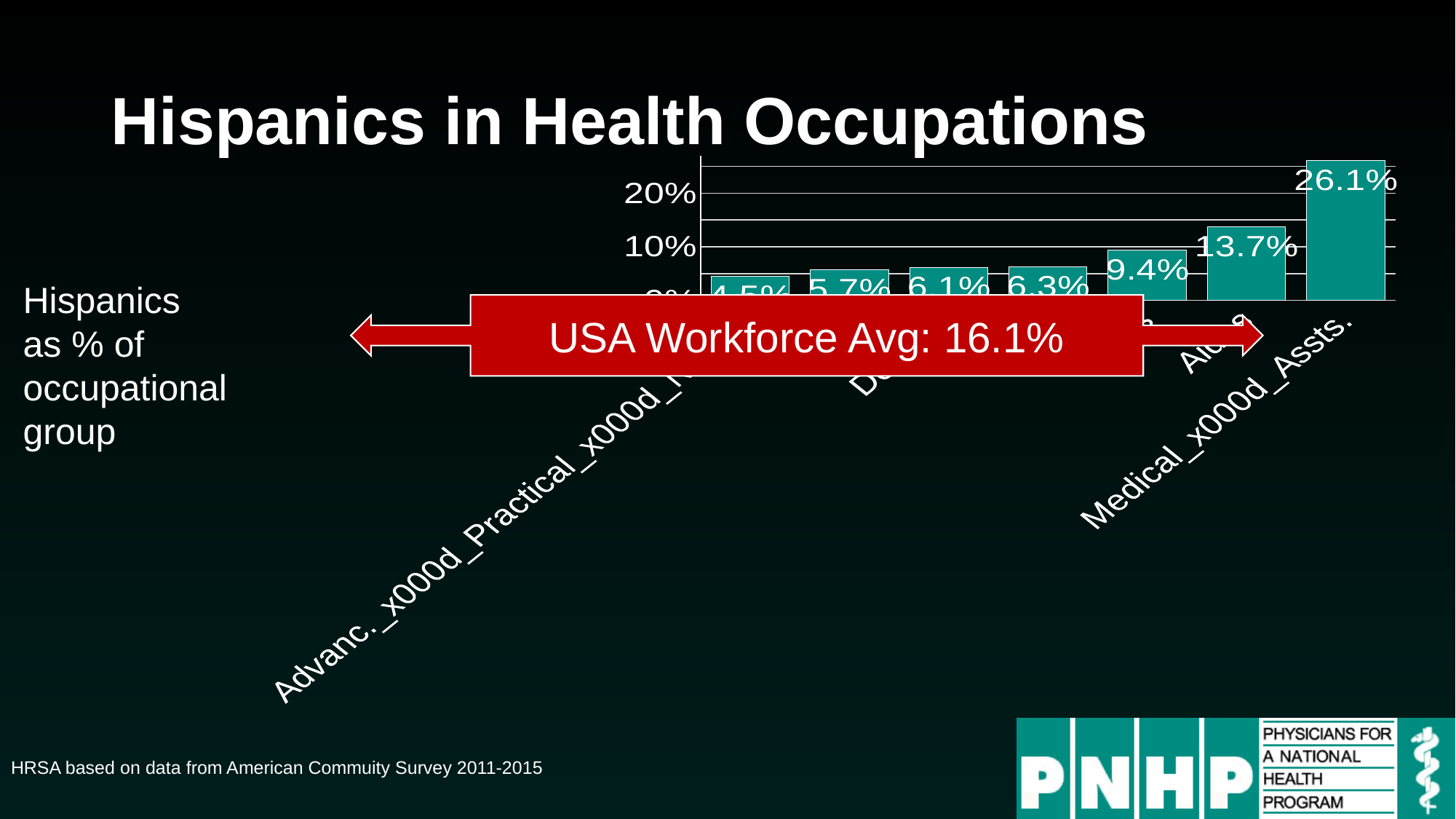
What is the value shown on the third bar from the right? 9.4% Which occupational group has the highest percentage of Hispanics in the chart? Medical Assts. Do the bar values rise or fall from left to right across the chart? rise How many bars (occupational groups) are plotted in the chart? 7 What is the value shown on the second-tallest bar in the chart? 13.7% What is the value shown for Medical Assts.? 26.1% Which is larger, the bar labelled 9.4% or the bar labelled 13.7%? 13.7% What kind of chart is shown on the slide? bar chart What is the difference between the tallest bar (26.1%) and the second-tallest bar (13.7%)? 12.4 percentage points What USA Workforce Avg value is shown in the red box over the chart? 16.1% How many bars exceed the USA Workforce Avg of 16.1% shown on the slide? 1 Is the value for Medical Assts. greater or less than 20%? greater